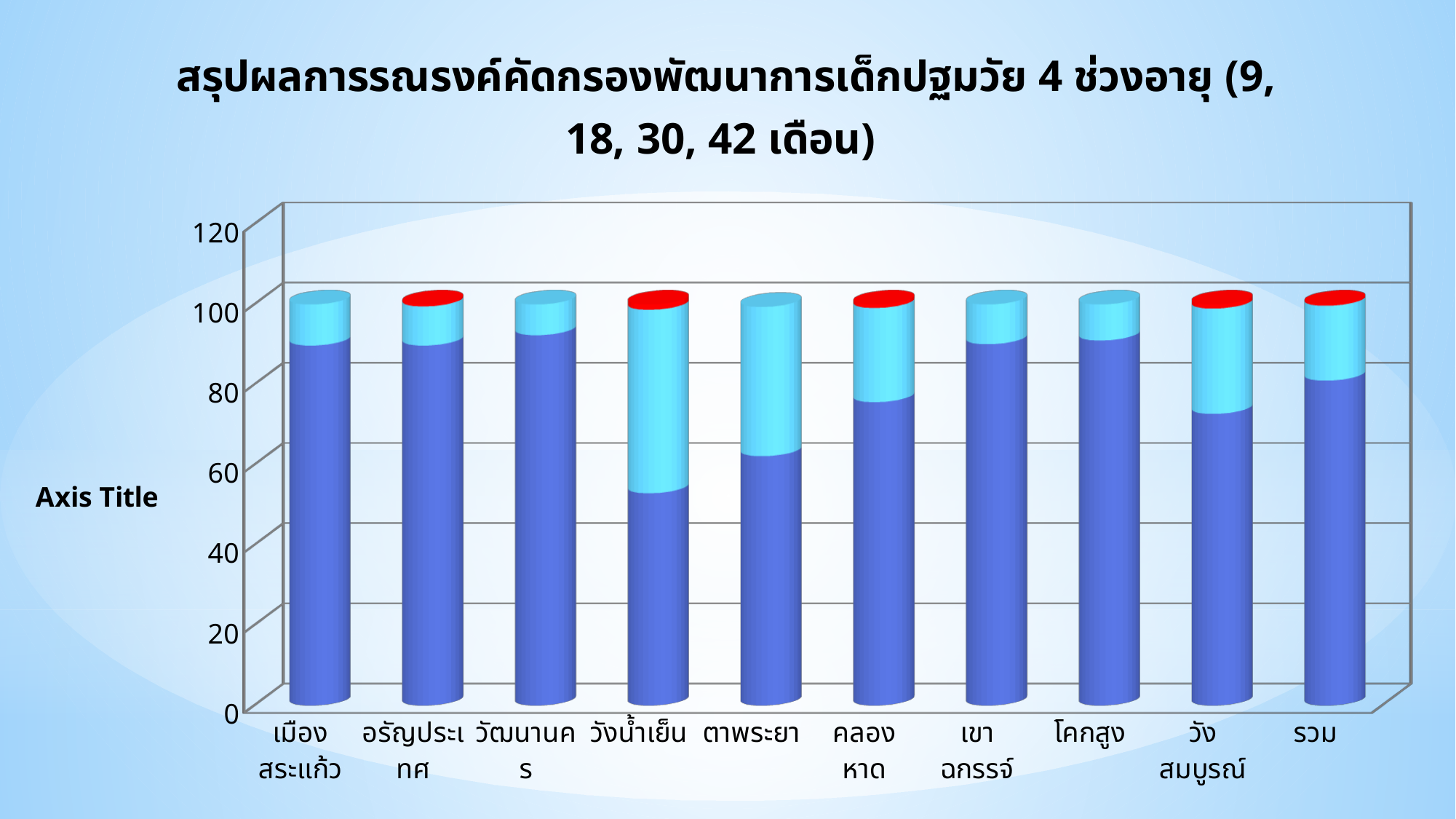
Is the dark blue segment for ตาพระยา greater or less than 80? less Is the dark blue segment for เมืองสระแก้ว greater or less than 80? greater Is the dark blue segment for วังสมบูรณ์ greater or less than 80? less What is the title of the vertical axis on the chart? Axis Title What is the title of the chart? สรุปผลการรณรงค์คัดกรองพัฒนาการเด็กปฐมวัย 4 ช่วงอายุ (9, 18, 30, 42 เดือน) How many categories are shown along the x axis of the chart? 10 What kind of chart is shown on the slide? Stacked bar chart Which has the larger dark blue segment, โคกสูง or ตาพระยา? โคกสูง Which category has the smallest dark blue segment? วังน้ำเย็น Which has the larger dark blue segment, เมืองสระแก้ว or วังน้ำเย็น? เมืองสระแก้ว